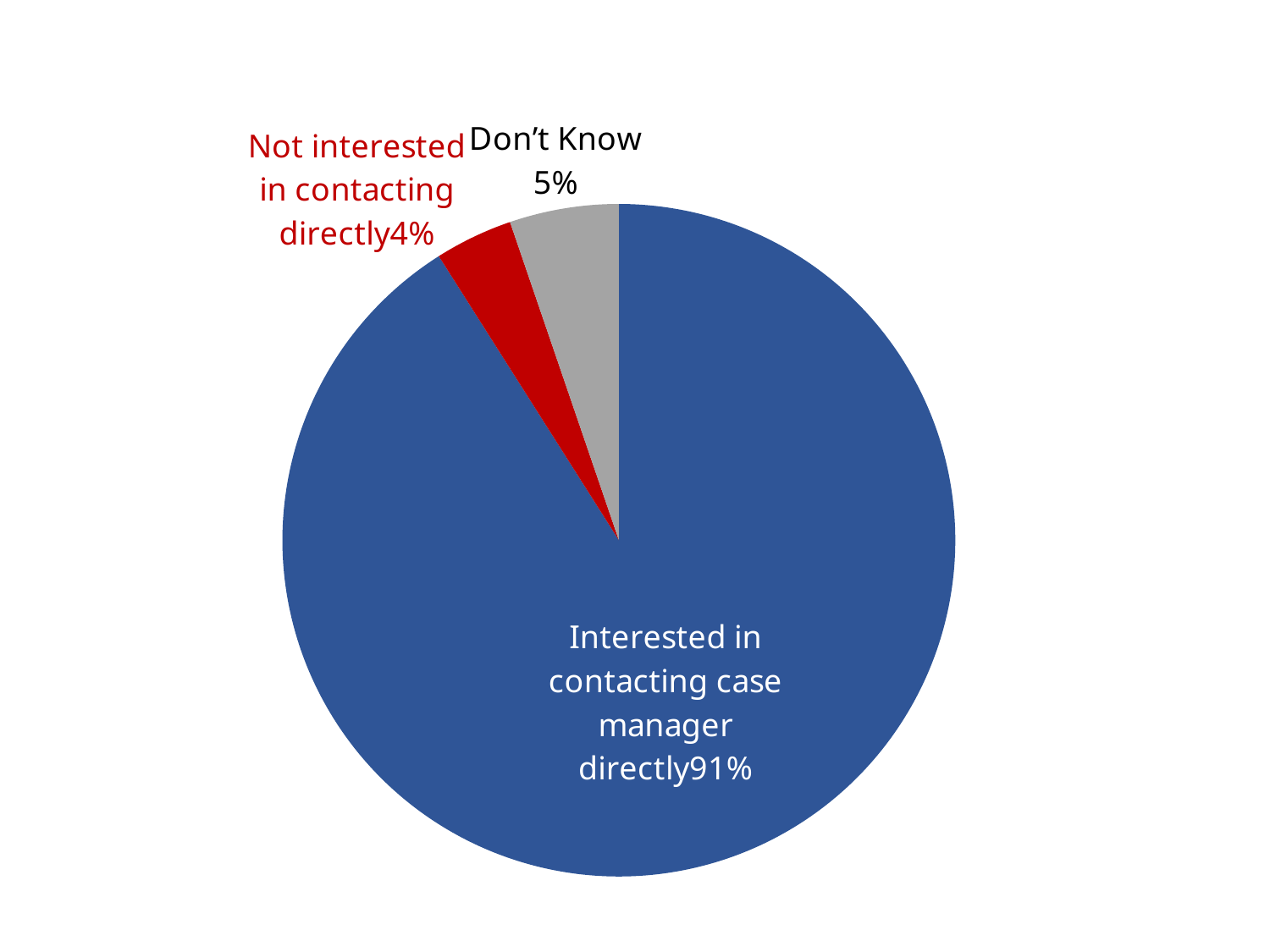
Which is larger, the 'Don't Know' slice or the 'Not interested in contacting directly' slice? Don't Know What is the difference in percentage points between the 'Don't Know' slice and the 'Not interested in contacting directly' slice? 1 What colour is the 'Don't Know' slice? grey What is the difference in percentage points between the 'Interested in contacting case manager directly' slice and the 'Don't Know' slice? 86 What share of the pie is labelled 'Not interested in contacting directly'? 4% What share of the pie is labelled 'Interested in contacting case manager directly'? 91% What kind of chart is shown on the slide? pie chart Which slice of the pie is the smallest? Not interested in contacting directly What share of the pie is labelled 'Don't Know'? 5% What colour is the 'Not interested in contacting directly' slice? red How many slices does the pie chart have? 3 Which slice of the pie is the largest? Interested in contacting case manager directly